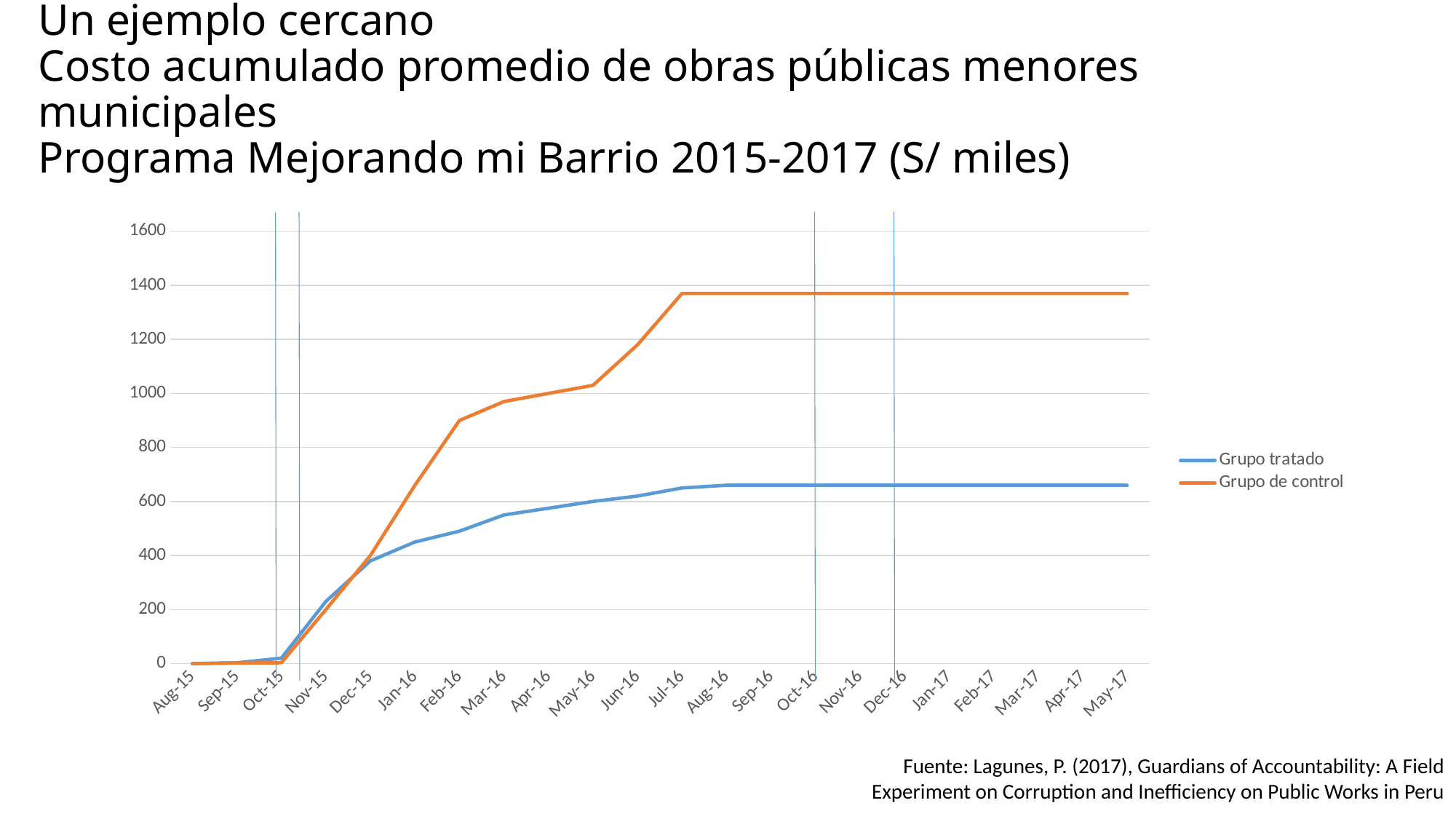
How many series does the legend list? 2 Is the value for Grupo tratado at May-17 greater or less than 800? less Is the value for Grupo tratado at Feb-16 greater or less than 600? less Is the value for Grupo de control at May-17 greater or less than 1200? greater Which colour is used for the Grupo tratado line? blue What kind of chart is shown on the slide? line chart Which series has the higher value at May-17, Grupo tratado or Grupo de control? Grupo de control Do the values for Grupo de control rise or fall from Aug-15 to Jul-16? rise What is the first month labelled on the x axis? Aug-15 How many months are labelled along the x axis? 22 What are the two series named in the legend? Grupo tratado and Grupo de control